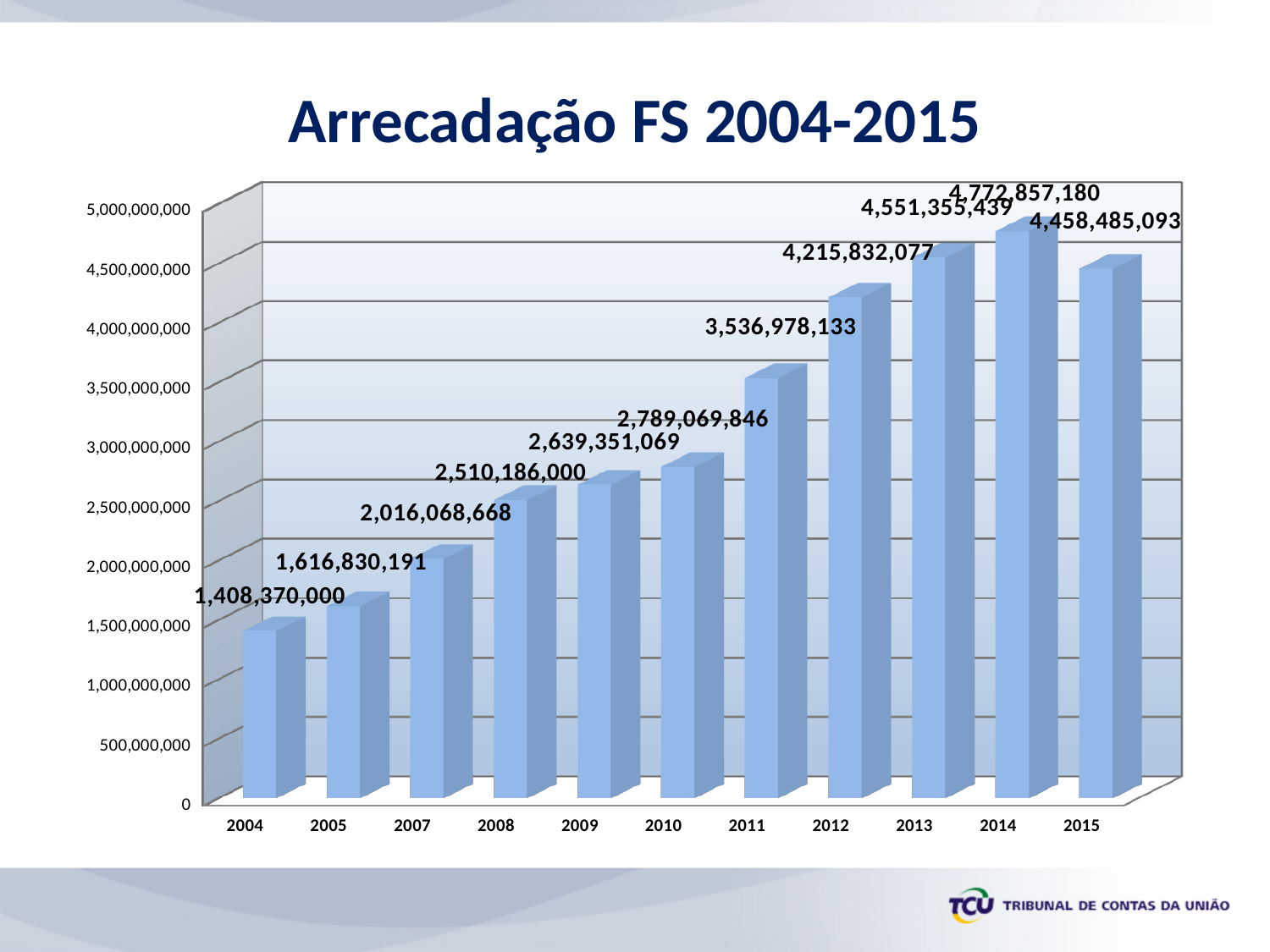
How many years (bars) are plotted in the chart? 11 Which year has the lowest value? 2004 What is the value for 2011? 3,536,978,133 Which year has the highest value? 2014 What type of chart is shown on the slide? bar chart What is the difference between the values for 2014 and 2015? 314,372,087 Which is larger, the value for 2013 or the value for 2015? 2013 What is the title of the chart? Arrecadação FS 2004-2015 What is the value for 2015? 4,458,485,093 What is the difference between the values for 2005 and 2004? 208,460,191 Is the value for 2012 greater or less than 4,000,000,000? greater What is the value for 2004? 1,408,370,000